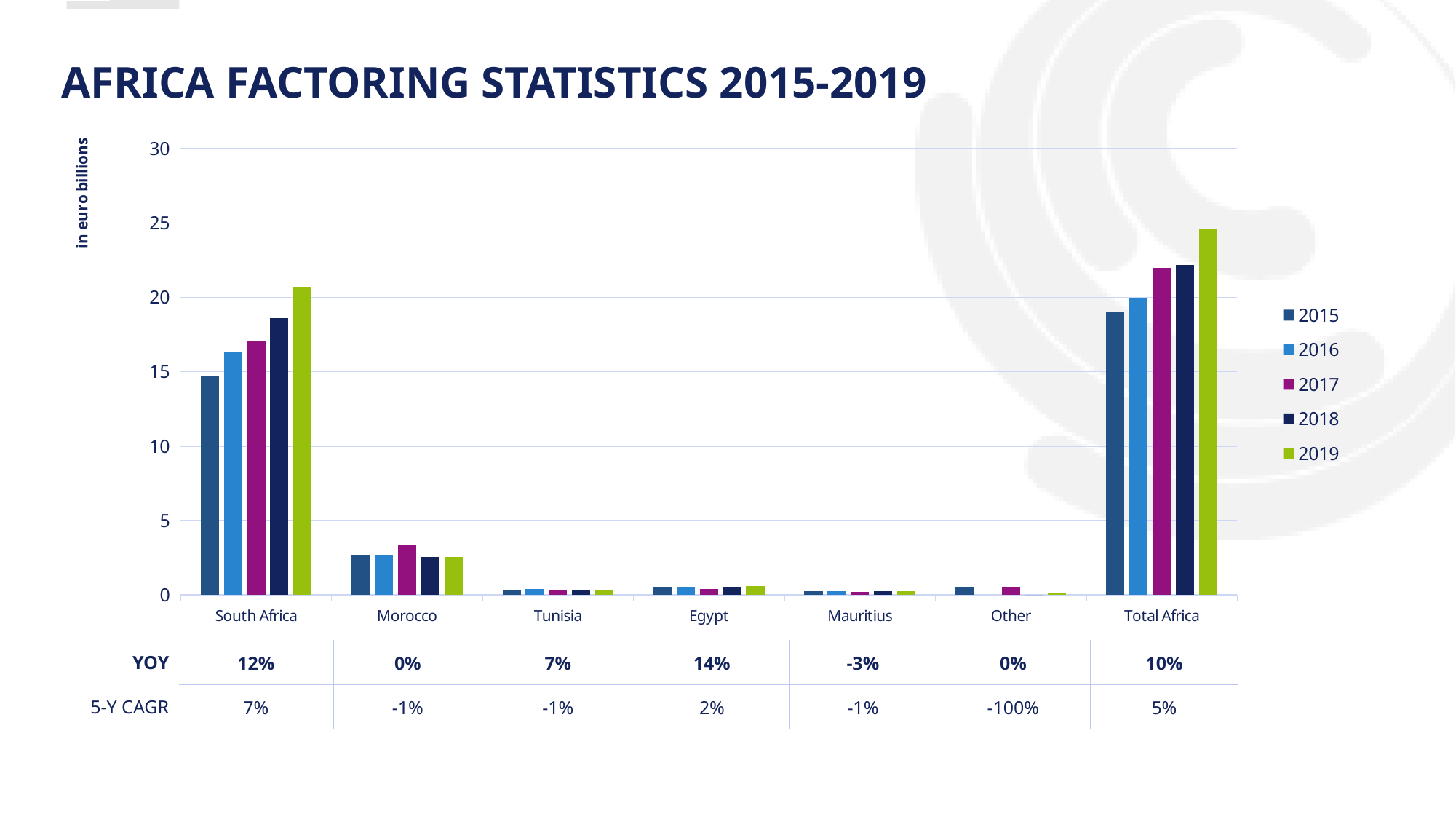
Do the values for South Africa rise or fall from 2015 to 2019? rise Is the value for Morocco in 2017 greater or less than 5? less What kind of chart is shown on the slide? bar chart Which is larger, the 2015 value for South Africa or the 2015 value for Morocco? South Africa Is the value for Total Africa in 2015 greater or less than 15? greater How many series does the legend list? 5 What is the YOY figure shown for Egypt? 14% Is the value for South Africa in 2019 greater or less than 20? greater Which category has the highest value for 2019? Total Africa What unit is given on the y axis of the chart? in euro billions What is the 5-Y CAGR figure shown for Other? -100% How many categories are shown on the x axis of the chart? 7